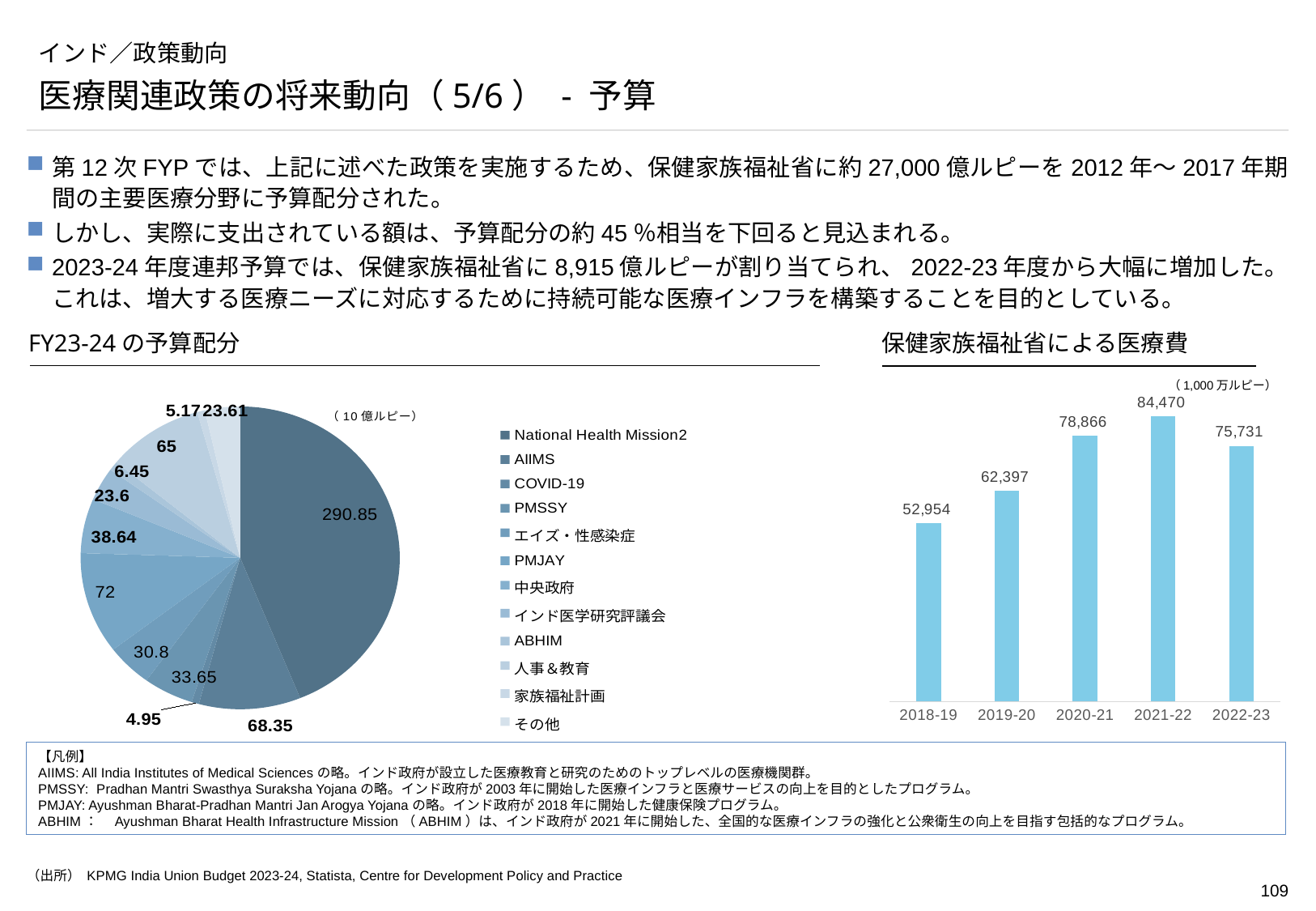
In the pie chart titled FY23-24の予算配分, what is the value of the largest slice? 290.85 In the bar chart titled 保健家族福祉省による医療費, do the values rise or fall from 2018-19 to 2021-22? rise How many entries does the legend of the pie chart titled FY23-24の予算配分 list? 12 In the bar chart titled 保健家族福祉省による医療費, what is the difference between the values for 2021-22 and 2022-23? 8,739 In the bar chart titled 保健家族福祉省による医療費, which year has the highest value? 2021-22 In the bar chart titled 保健家族福祉省による医療費, which year has the lowest value? 2018-19 In the bar chart titled 保健家族福祉省による医療費, what is the value for 2018-19? 52,954 In the bar chart titled 保健家族福祉省による医療費, what is the value for 2021-22? 84,470 What unit is shown next to the pie chart titled FY23-24の予算配分? 10億ルピー How many bars are shown in the bar chart titled 保健家族福祉省による医療費? 5 In the bar chart titled 保健家族福祉省による医療費, which is larger, the value for 2019-20 or 2020-21? 2020-21 What kind of chart is the chart titled 保健家族福祉省による医療費? bar chart